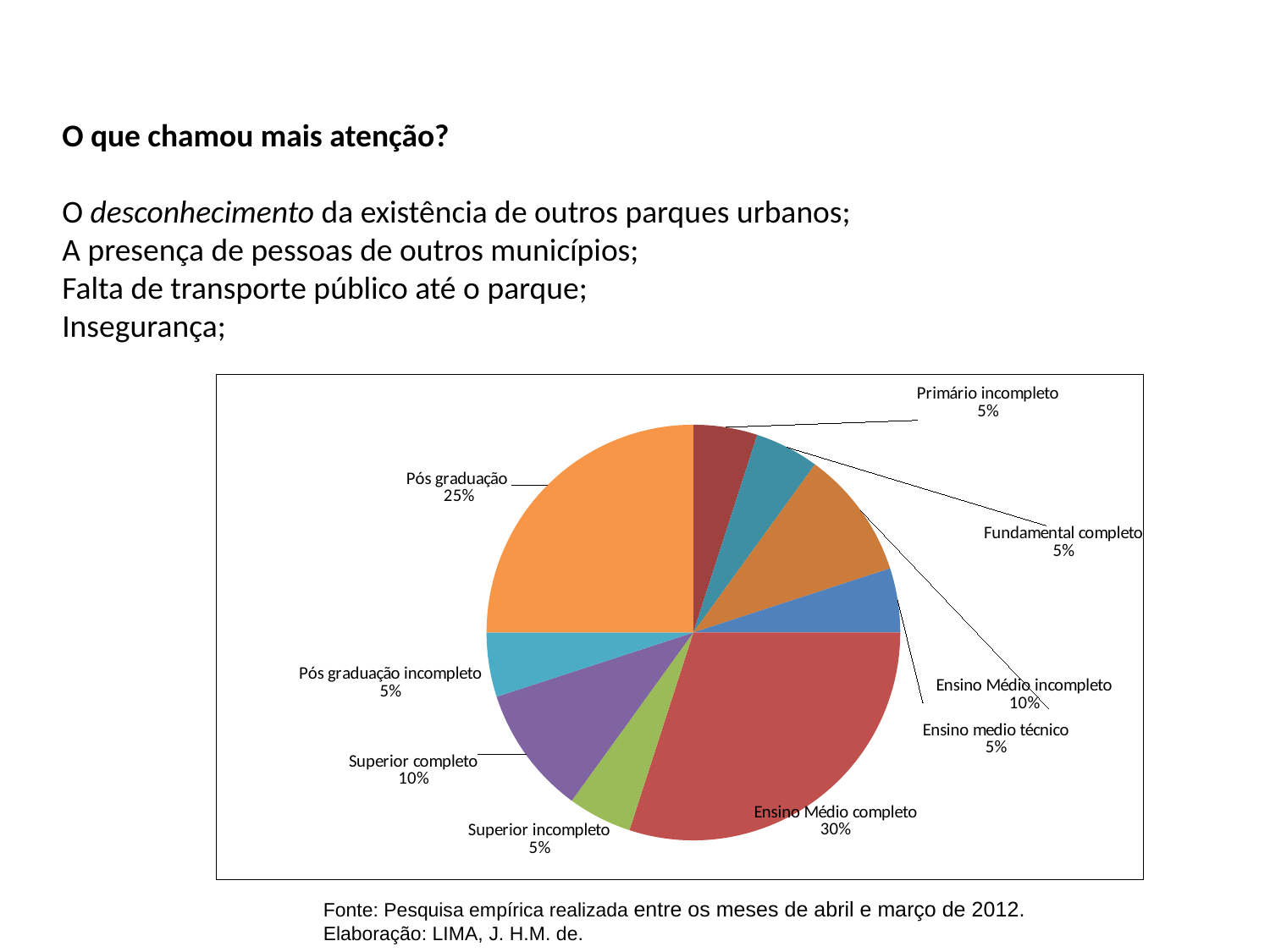
What kind of chart is shown on the slide? pie chart What is the value shown for Ensino Médio incompleto? 10% What is the difference between the shares of Ensino Médio completo and Pós graduação? 5% What share of the pie does Pós graduação represent? 25% What is the combined share of Ensino Médio completo and Ensino Médio incompleto? 40% What is the value shown for Superior completo? 10% What is the difference between the shares of Pós graduação and Pós graduação incompleto? 20% Which category has the largest slice of the pie? Ensino Médio completo What share of the pie does Ensino Médio completo represent? 30% Which is larger, the share for Superior completo or the share for Superior incompleto? Superior completo How many slices does the pie chart have? 9 What is the value shown for Primário incompleto? 5%